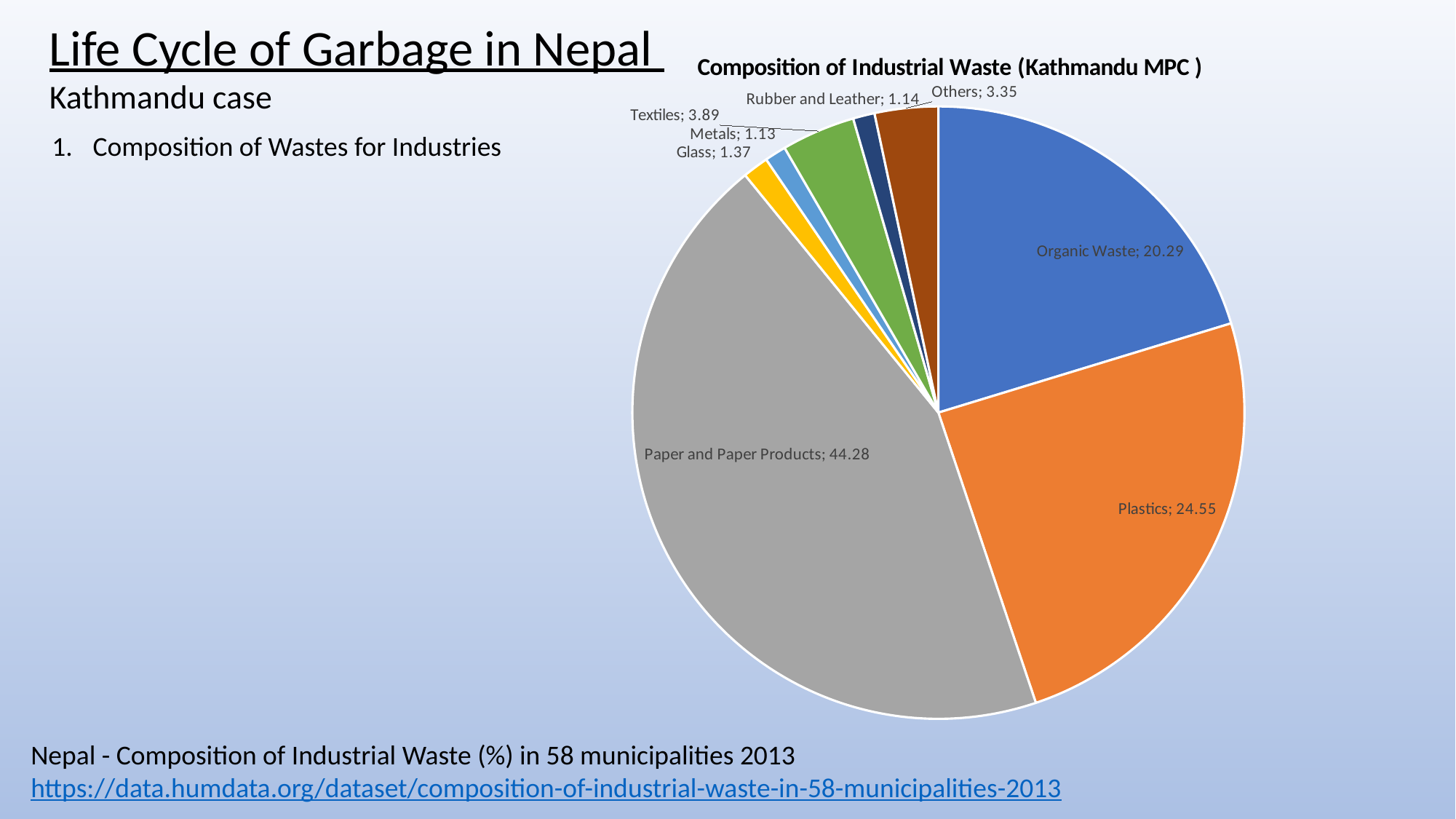
What is the value for Plastics? 24.55 What is the title of the pie chart? Composition of Industrial Waste (Kathmandu MPC ) How many slices does the pie chart have? 8 What is the value for Textiles? 3.89 What colour is the Paper and Paper Products slice? grey Which category has the largest slice of the pie? Paper and Paper Products What is the value for Paper and Paper Products? 44.28 What is the difference between the values for Plastics and Organic Waste? 4.26 What is the value for Glass? 1.37 Which is larger, Plastics or Organic Waste? Plastics What is the value for Organic Waste? 20.29 What kind of chart is shown on the slide? pie chart